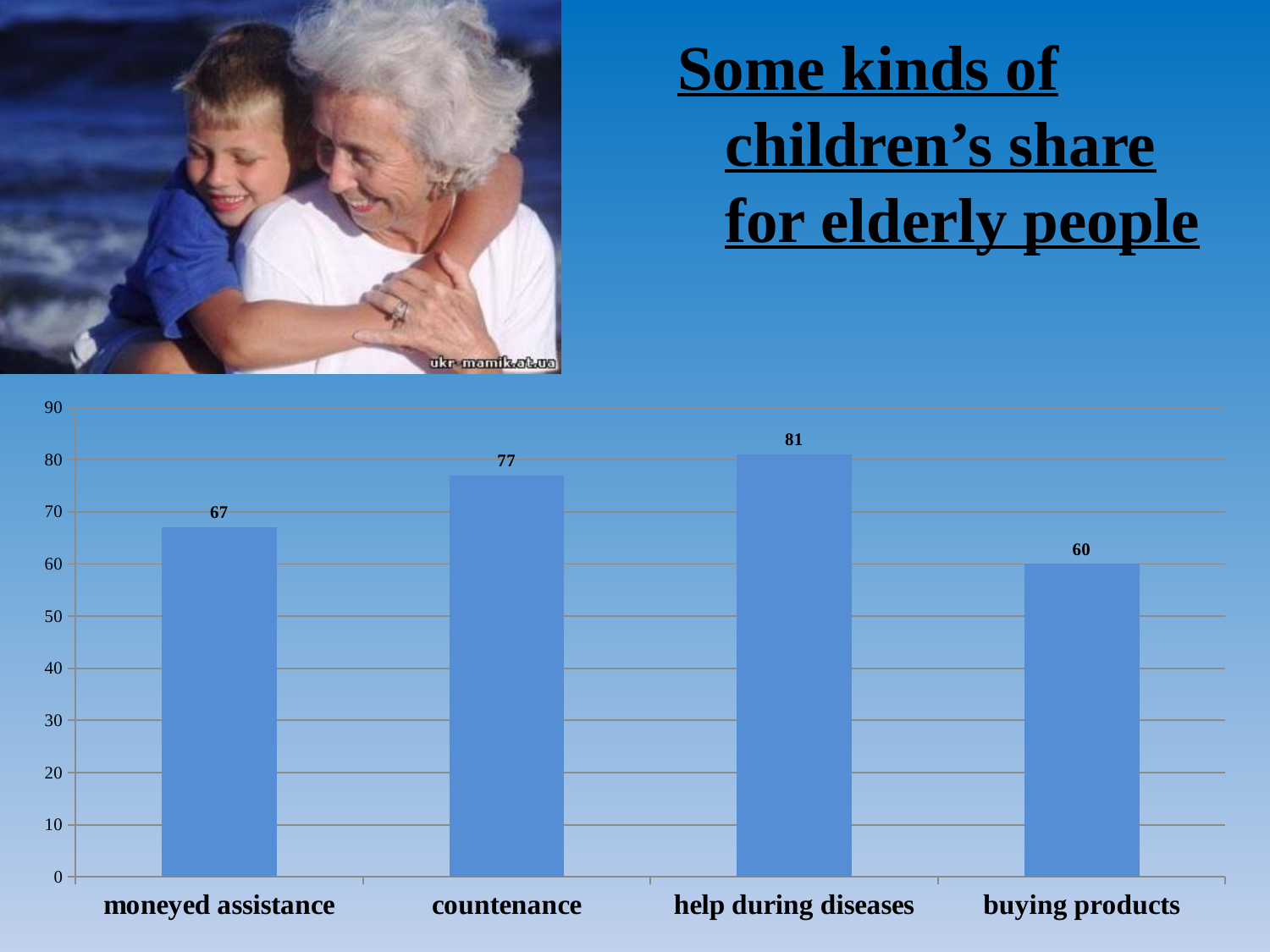
What is the value for countenance? 77 Which category has the highest value? help during diseases What is the difference between the values for help during diseases and buying products? 21 What kind of chart is shown on the slide? bar chart Which is larger, the value for countenance or the value for moneyed assistance? countenance What is the value for moneyed assistance? 67 Which category has the lowest value? buying products What is the difference between the values for countenance and moneyed assistance? 10 Is the value for buying products greater or less than 70? less What is the value for buying products? 60 How many categories are shown in the chart? 4 What is the value for help during diseases? 81